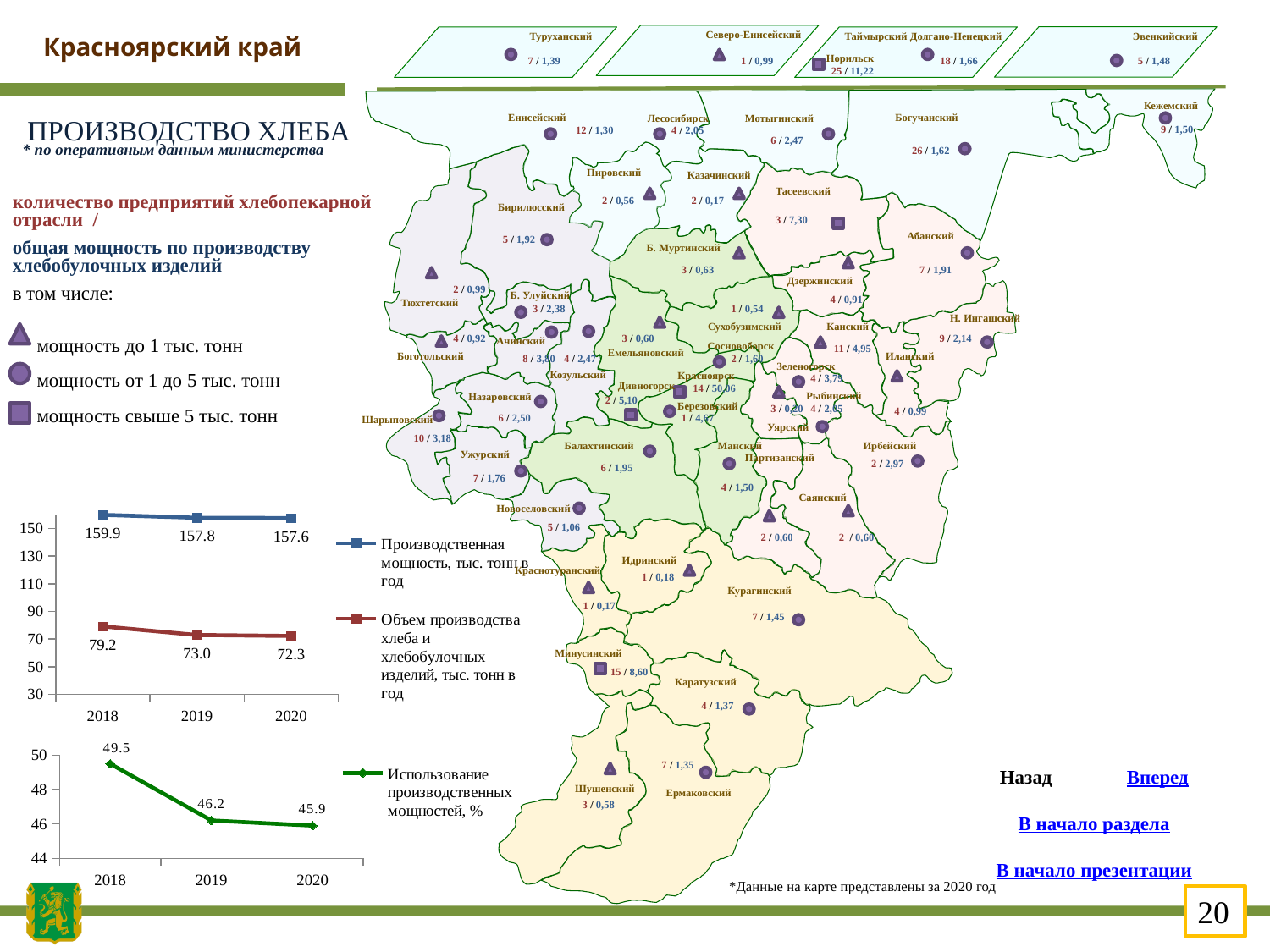
On the lower line chart, do the values rise or fall from 2018 to 2020? fall How many series does the legend of the upper line chart list? 2 On the lower line chart, what is the difference between the 2018 and 2020 values of 'Использование производственных мощностей, %'? 3.6 On the lower line chart, what is the value of 'Использование производственных мощностей, %' for 2019? 46.2 On the upper line chart, what is the value of 'Производственная мощность, тыс. тонн в год' for 2018? 159.9 On the upper line chart, what is the difference between 'Производственная мощность' and 'Объем производства' in 2018? 80.7 On the upper line chart, in which year is 'Производственная мощность, тыс. тонн в год' lowest? 2020 On the lower line chart, in which year is 'Использование производственных мощностей, %' highest? 2018 On the upper line chart, what is the value of 'Объем производства хлеба и хлебобулочных изделий, тыс. тонн в год' for 2020? 72.3 On the upper line chart, what is the value of 'Объем производства хлеба и хлебобулочных изделий, тыс. тонн в год' for 2019? 73.0 On the upper line chart, which is larger in 2019: 'Производственная мощность' or 'Объем производства'? Производственная мощность What kind of chart is the lower chart showing 'Использование производственных мощностей, %'? line chart